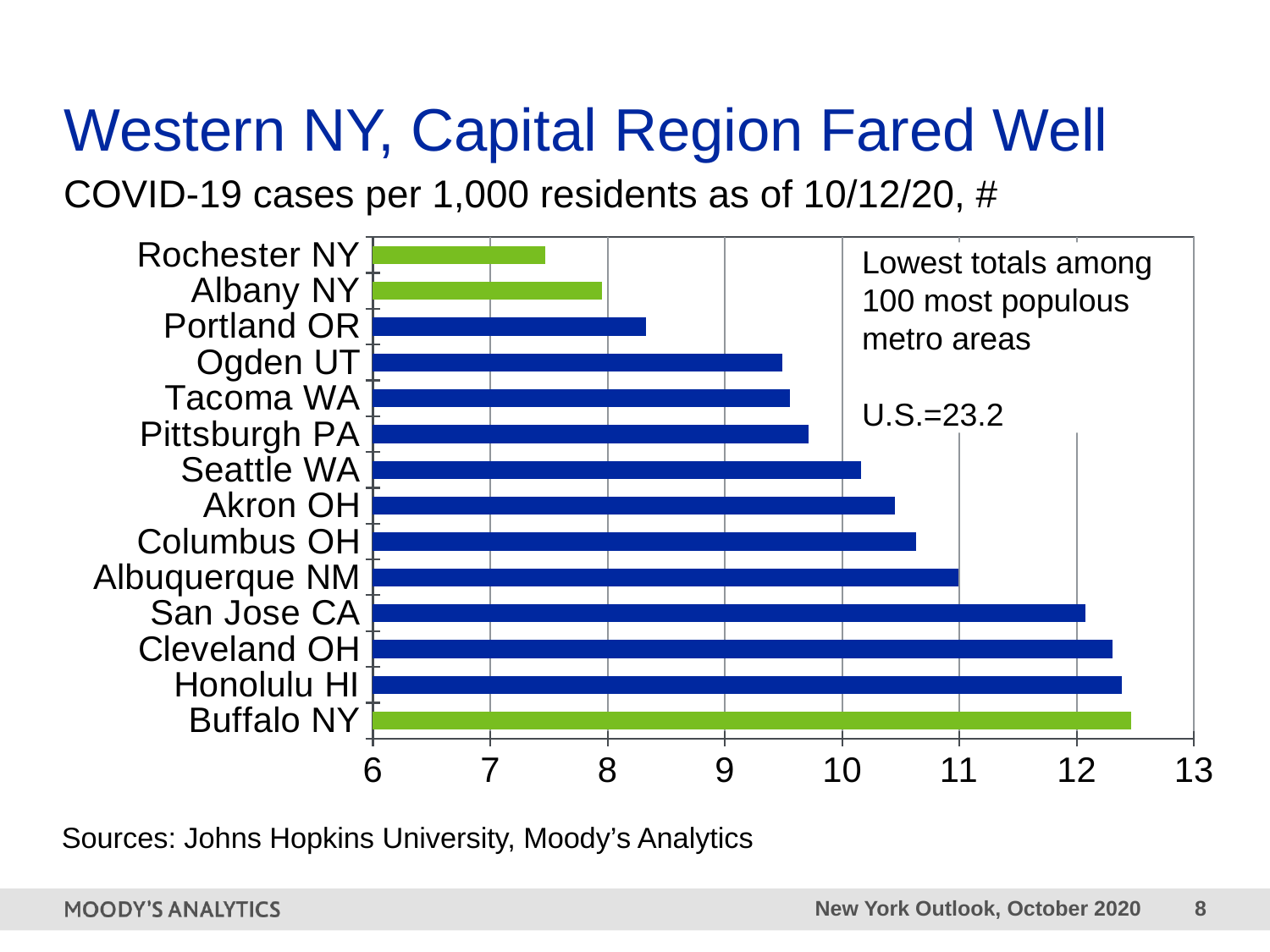
Is the value for Ogden UT greater or less than 9? greater Which has more COVID-19 cases per 1,000 residents, Portland OR or Ogden UT? Ogden UT According to the annotation on the chart, what is the U.S. value for COVID-19 cases per 1,000 residents? 23.2 What kind of chart is shown on the slide? bar chart Is the value for Portland OR greater or less than 8? greater Is the value for Cleveland OH greater or less than 12? greater How many metro areas are plotted in the chart? 14 Which metro area has the lowest COVID-19 cases per 1,000 residents in the chart? Rochester NY Which has more COVID-19 cases per 1,000 residents, Albany NY or Seattle WA? Seattle WA